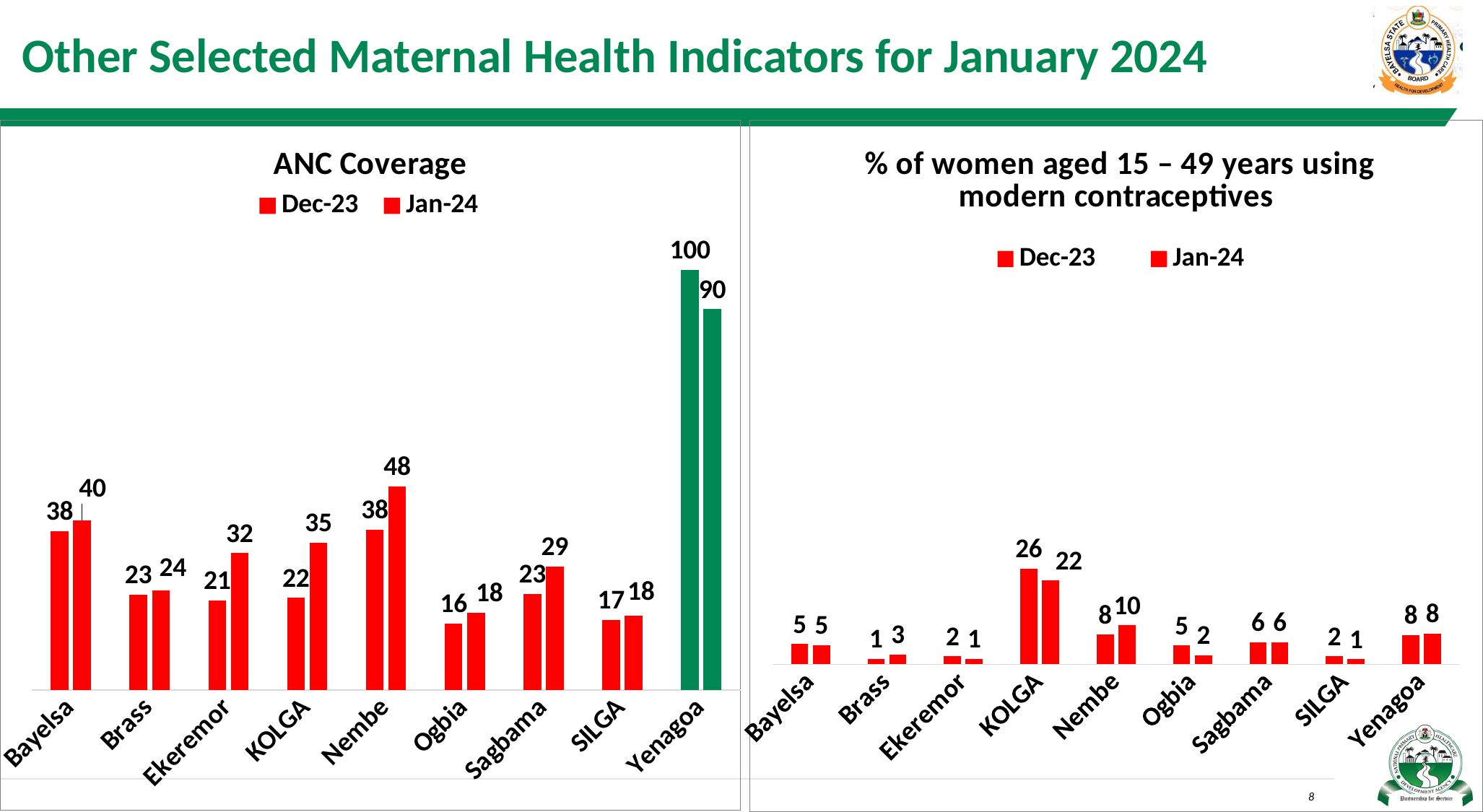
In the ANC Coverage chart, which category has the highest Jan-24 value? Yenagoa In the '% of women aged 15 – 49 years using modern contraceptives' chart, what is the Dec-23 value for KOLGA? 26 In the ANC Coverage chart, what is the Dec-23 value for Ekeremor? 21 In the '% of women aged 15 – 49 years using modern contraceptives' chart, is the Jan-24 value for Brass larger or smaller than the Jan-24 value for Ogbia? larger In the '% of women aged 15 – 49 years using modern contraceptives' chart, which category has the highest Jan-24 value? KOLGA In the '% of women aged 15 – 49 years using modern contraceptives' chart, what is the Jan-24 value for Nembe? 10 In the ANC Coverage chart, what is the Jan-24 value for Nembe? 48 In the ANC Coverage chart, what is the difference between the Dec-23 and Jan-24 values for Yenagoa? 10 How many series does the legend of the ANC Coverage chart list? 2 What kind of chart is the '% of women aged 15 – 49 years using modern contraceptives' chart? bar chart In the ANC Coverage chart, how many categories are shown on the x axis? 9 In the ANC Coverage chart, which category has the lowest Dec-23 value? Ogbia